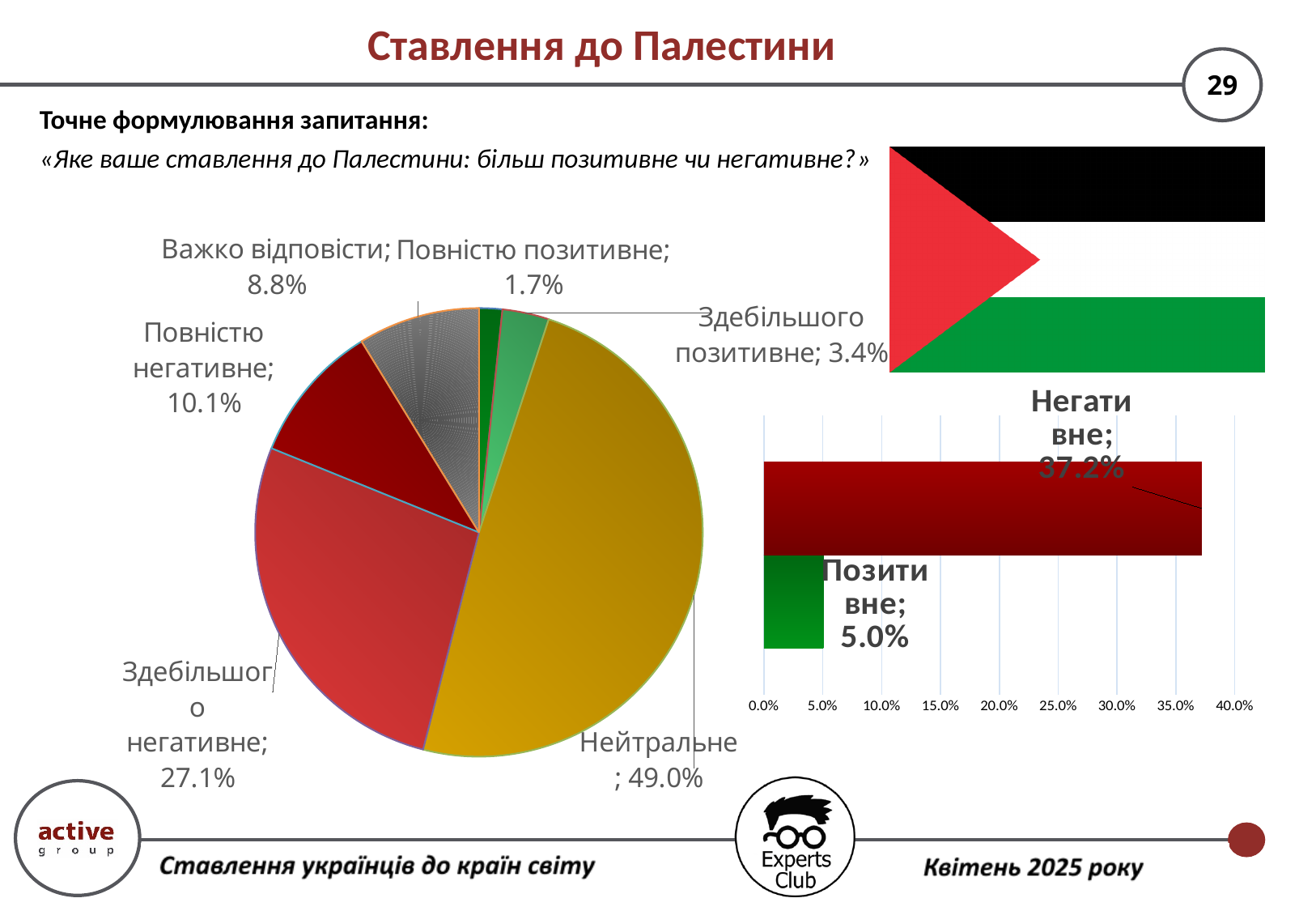
In the bar chart on the right, what is the difference between "Негативне" and "Позитивне"? 32.2% In the bar chart on the right, what is the value for "Негативне"? 37.2% In the pie chart on the left, what share is labelled "Нейтральне"? 49.0% In the pie chart on the left, which category has the largest slice? Нейтральне What kind of chart is shown on the right side of the slide? Bar chart In the pie chart on the left, what share is labelled "Повністю позитивне"? 1.7% In the bar chart on the right, what is the value for "Позитивне"? 5.0% In the pie chart on the left, which category has the smallest slice? Повністю позитивне In the pie chart on the left, which is larger: "Здебільшого позитивне" or "Повністю негативне"? Повністю негативне In the pie chart on the left, what share is labelled "Здебільшого негативне"? 27.1% In the pie chart on the left, what is the difference between "Повністю негативне" and "Важко відповісти"? 1.3% In the pie chart on the left, how many slices are there? 6